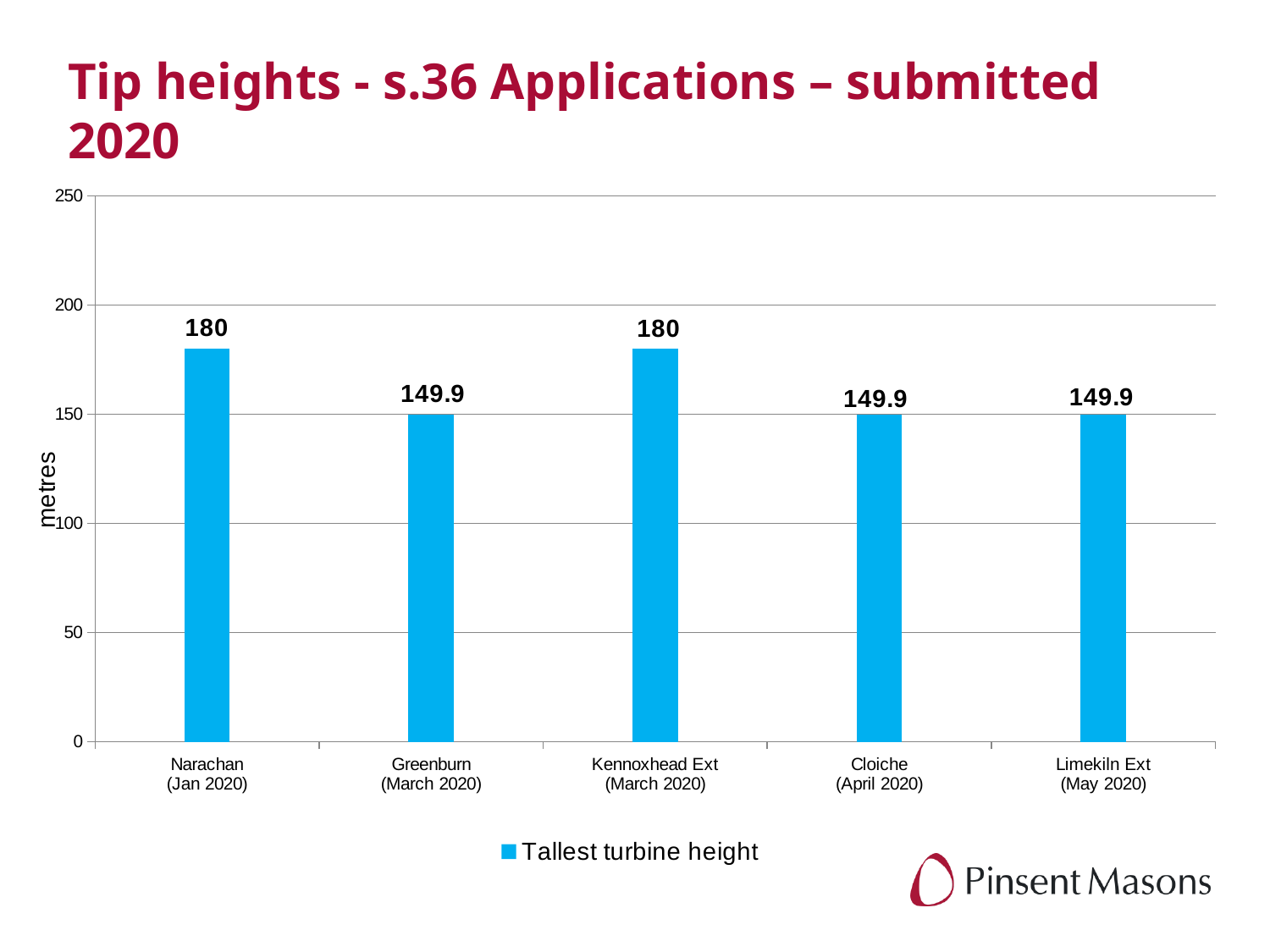
What is the tallest turbine height for Cloiche (April 2020)? 149.9 What kind of chart is shown on the slide? bar chart What is the difference in tallest turbine height between Kennoxhead Ext and Cloiche? 30.1 Which is larger, the tallest turbine height for Narachan or for Greenburn? Narachan Is the tallest turbine height for Limekiln Ext greater or less than 100? greater How many series does the legend list? 1 How many applications (categories) are shown on the chart? 5 What is the tallest turbine height for Narachan (Jan 2020)? 180 What is the title of the chart on the slide? Tip heights - s.36 Applications – submitted 2020 What is the label on the vertical axis of the chart? metres What is the tallest turbine height for Limekiln Ext (May 2020)? 149.9 What is the tallest turbine height for Greenburn (March 2020)? 149.9